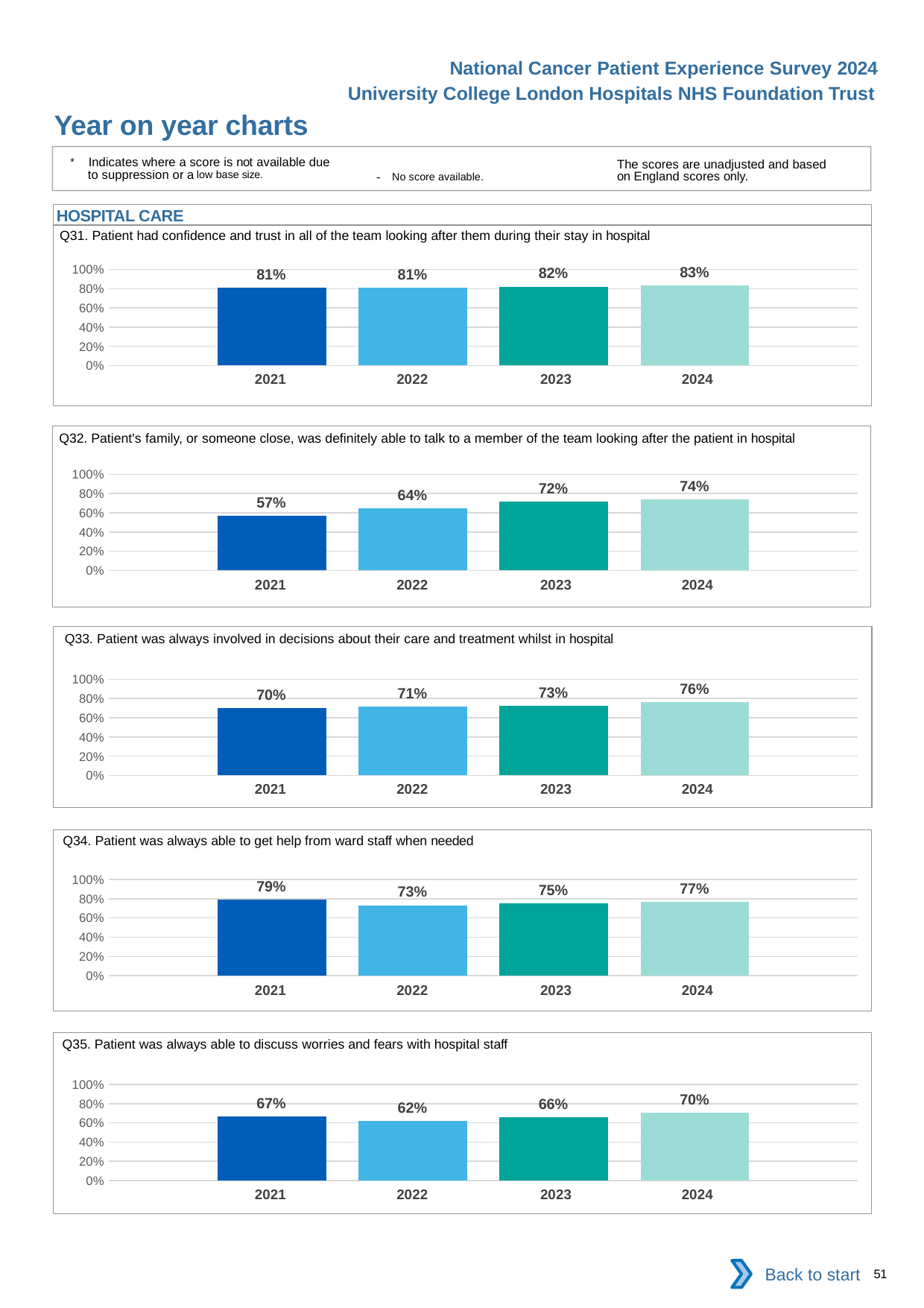
How many years are shown in the Q33 chart? 4 In the Q34 chart, which is larger, the value for 2021 or the value for 2024? 2021 In the Q32 chart, what is the difference between the 2024 value and the 2021 value? 17% In the Q31 chart, what is the value for 2024? 83% What kind of chart is the Q31 chart? bar chart In the Q32 chart, which year has the highest value? 2024 In the Q35 chart, what is the value for 2023? 66% How many charts are shown on the slide? 5 In the Q34 chart, which year has the lowest value? 2022 In the Q32 chart, what is the value for 2021? 57% In the Q35 chart, is the value for 2022 greater or less than 80%? less In the Q33 chart, do the values rise or fall from 2021 to 2024? rise